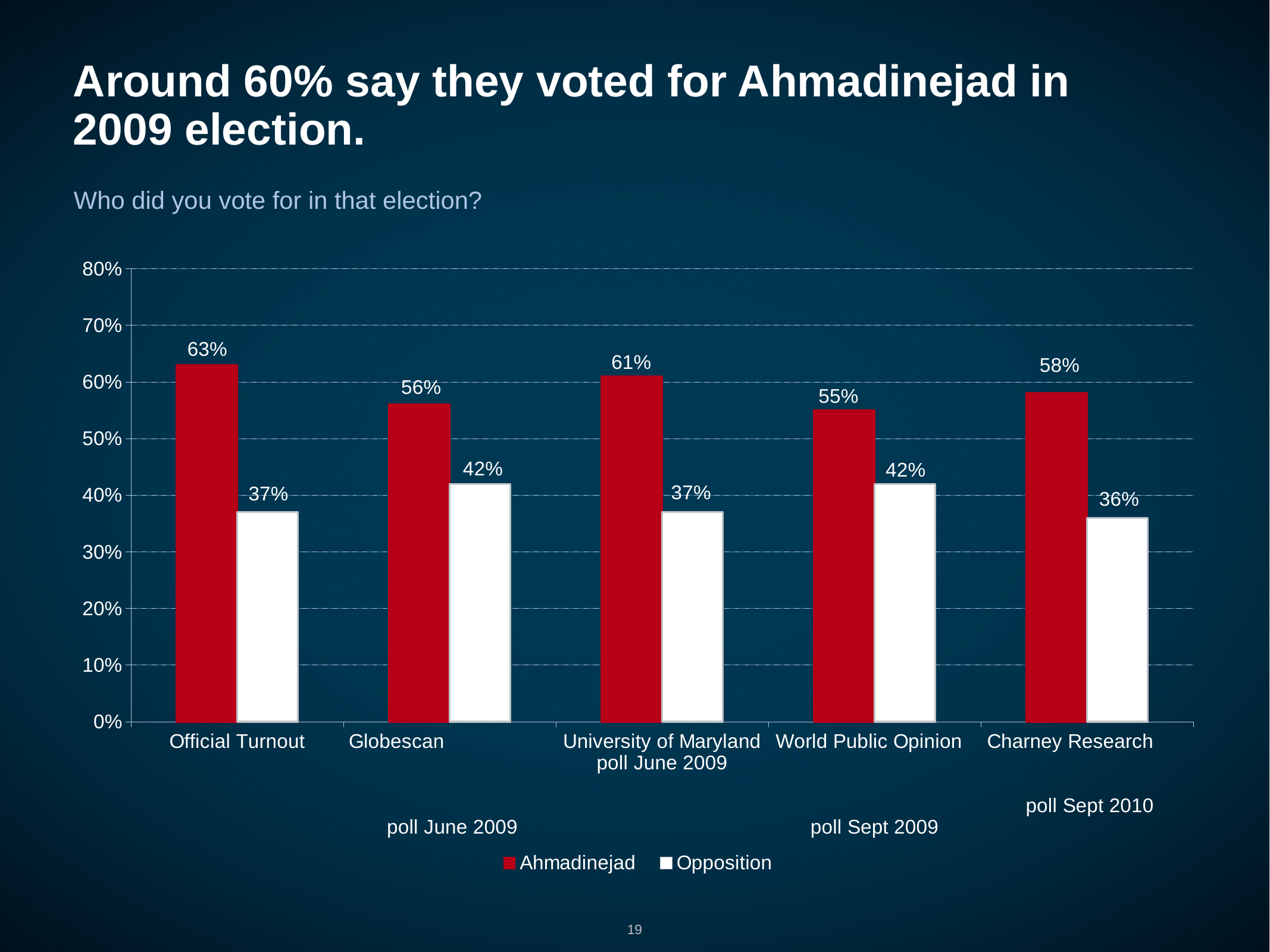
What is the difference between the Ahmadinejad and Opposition values for University of Maryland? 24% Which category has the lowest Ahmadinejad value? World Public Opinion What colour are the Ahmadinejad bars? Red Which category has the lowest Opposition value? Charney Research Which is larger: the Ahmadinejad value for Globescan or the Ahmadinejad value for University of Maryland? University of Maryland What kind of chart is shown on the slide? Bar chart How many series does the legend list? 2 What is the Opposition value for Globescan? 42% What percentage is shown for Ahmadinejad under Official Turnout? 63% How many categories are shown on the x axis? 5 Which category has the highest Ahmadinejad value? Official Turnout What is the Ahmadinejad value for Charney Research? 58%